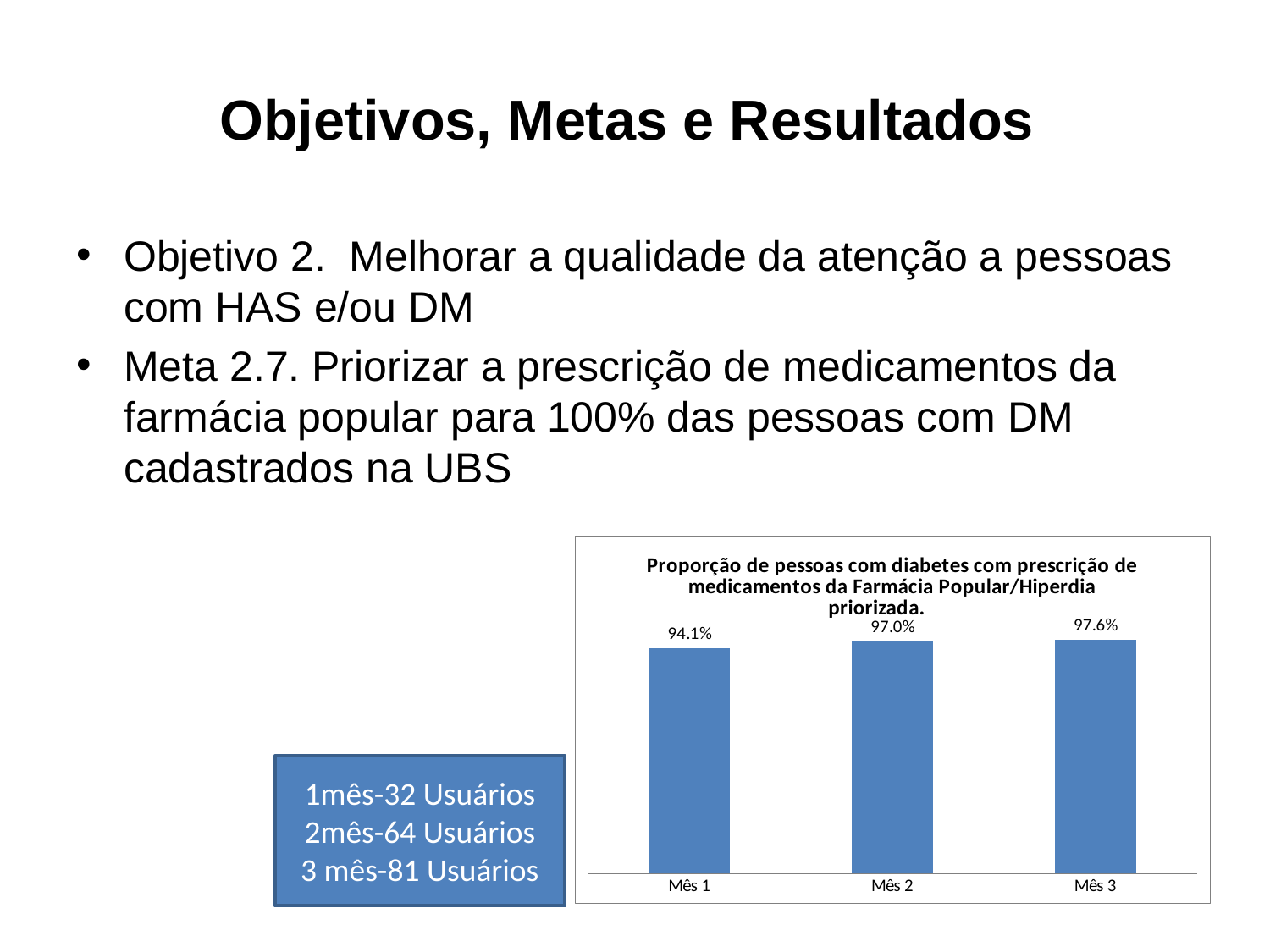
What is the difference between the values for Mês 3 and Mês 1? 3.5 percentage points What is the difference between the values for Mês 2 and Mês 1? 2.9 percentage points What kind of chart is shown on the slide? Bar chart What is the value for Mês 3 in the chart? 97.6% What is the title of the chart? Proporção de pessoas com diabetes com prescrição de medicamentos da Farmácia Popular/Hiperdia priorizada. Which is larger, the value for Mês 1 or the value for Mês 2? Mês 2 Which month has the lowest value in the chart? Mês 1 How many months (categories) are shown in the chart? 3 Which month has the highest value in the chart? Mês 3 Do the values rise or fall from Mês 1 to Mês 3? Rise What is the value for Mês 1 in the chart? 94.1% What is the value for Mês 2 in the chart? 97.0%